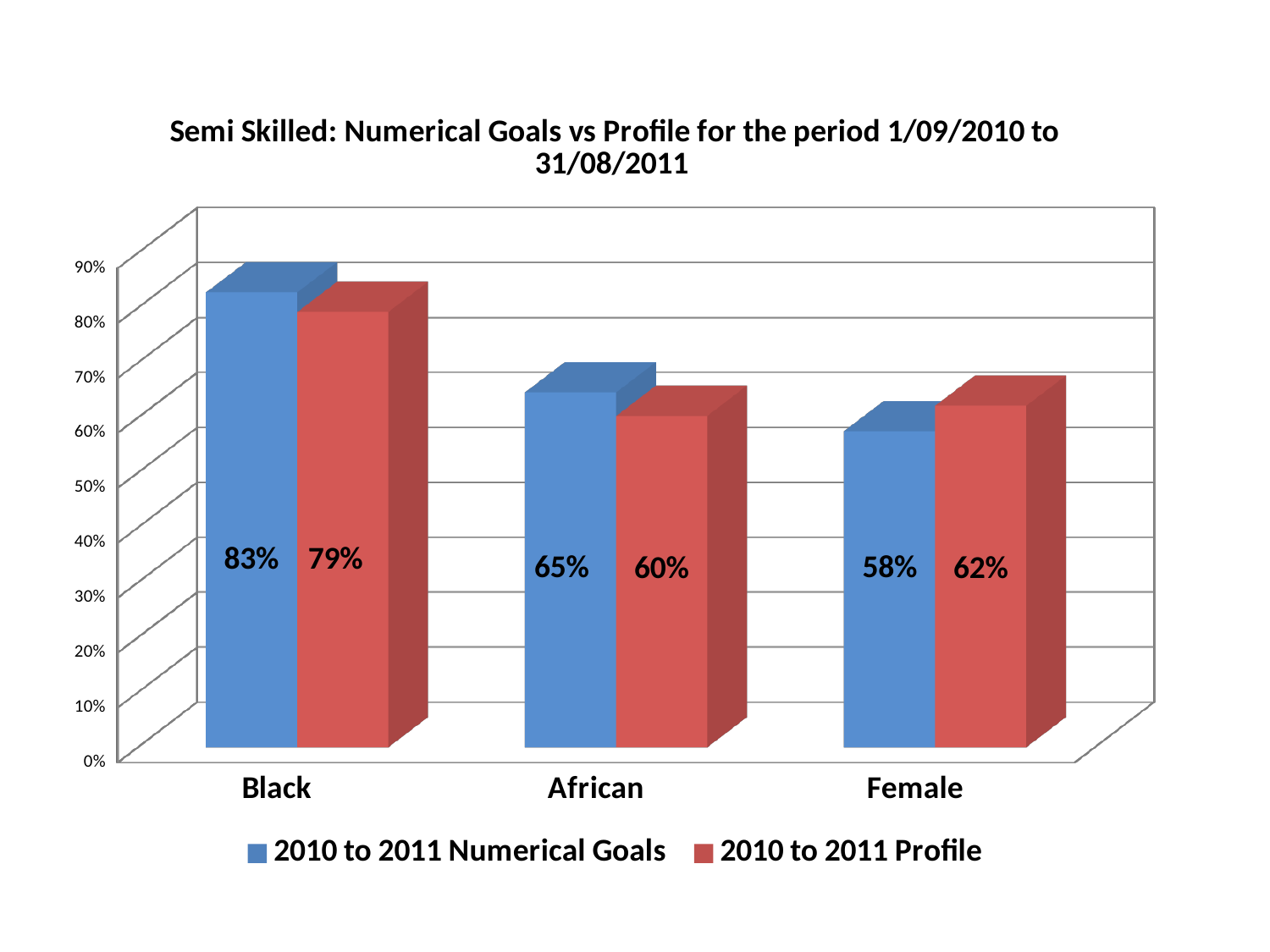
What is the 2010 to 2011 Profile value for Female? 62% What is the 2010 to 2011 Numerical Goals value for Black? 83% Which category has the lowest 2010 to 2011 Profile value? African What is the difference between the Numerical Goals and Profile values for Black? 4% What colour represents the 2010 to 2011 Profile series? Red How many series does the legend list? 2 Is the 2010 to 2011 Numerical Goals value for African greater or less than 70%? less What kind of chart is shown on the slide? Bar chart Which category has the highest 2010 to 2011 Numerical Goals value? Black What is the 2010 to 2011 Profile value for African? 60% For Female, which is larger: the 2010 to 2011 Numerical Goals value or the 2010 to 2011 Profile value? 2010 to 2011 Profile How many categories are shown on the x axis? 3